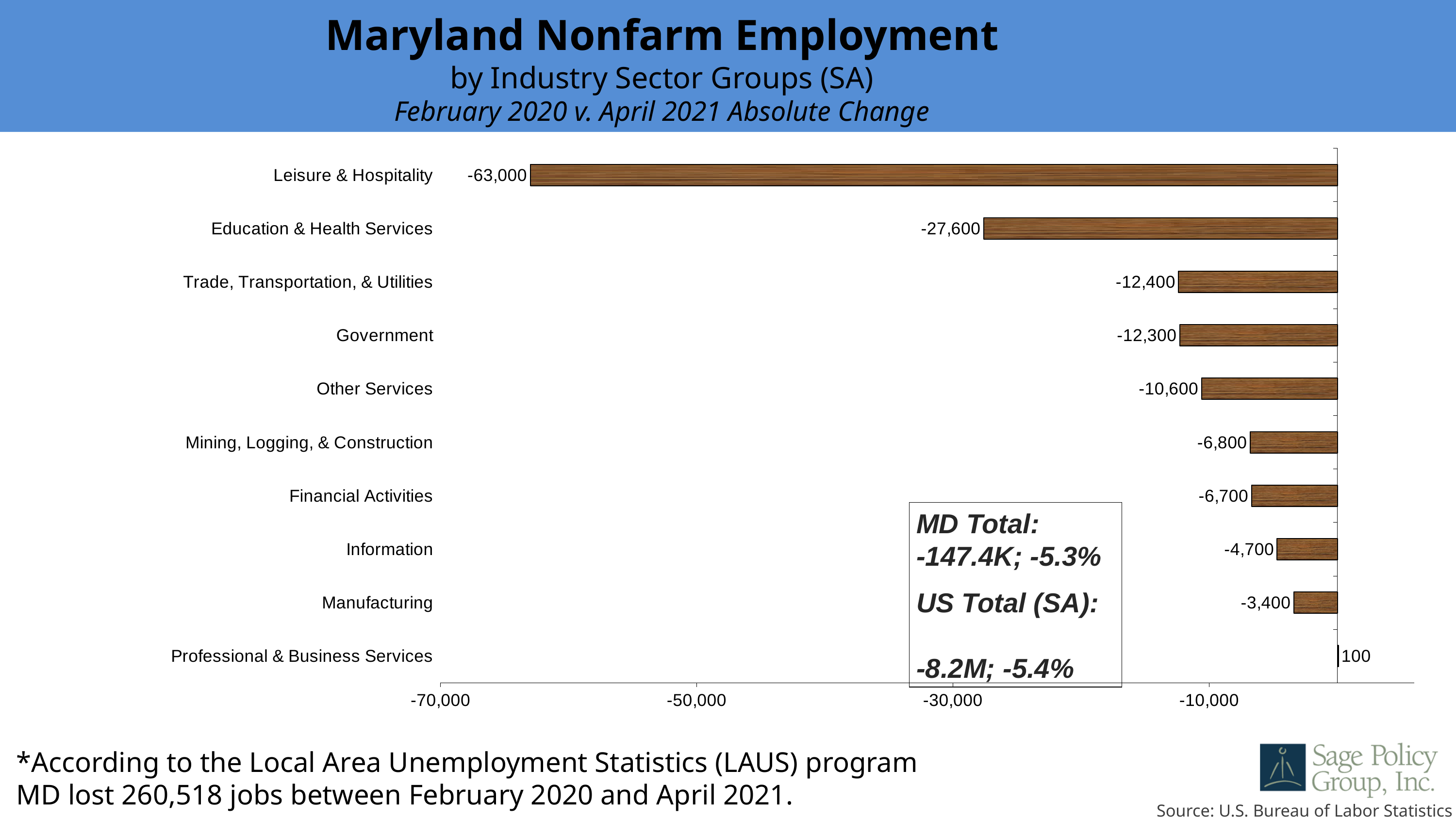
What is the absolute change in employment for Professional & Business Services? 100 What type of chart is shown on the slide? Bar chart What is the absolute change in employment for Education & Health Services? -27,600 What is the absolute change in employment for Government? -12,300 How many industry sector groups are shown in the chart? 10 Which sector lost more jobs, Information or Manufacturing? Information What is the absolute change in employment for Leisure & Hospitality? -63,000 What is the difference between the changes for Leisure & Hospitality and Education & Health Services? 35,400 Which industry sector group had the largest job loss? Leisure & Hospitality What is the MD Total absolute change shown in the text box on the chart? -147.4K; -5.3% What is the difference between the changes for Trade, Transportation, & Utilities and Government? 100 Which industry sector group is the only one with a positive change? Professional & Business Services